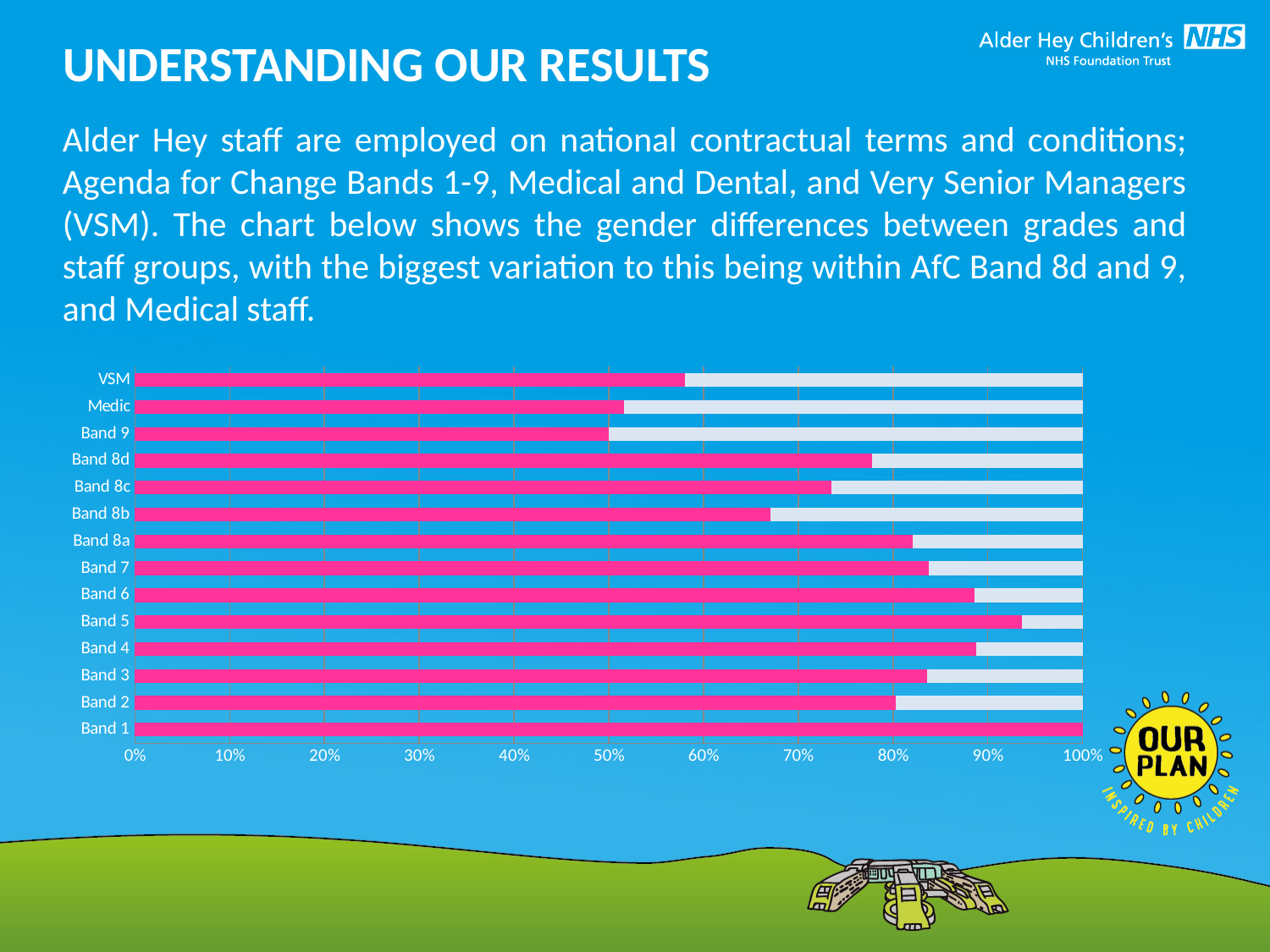
How many categories (staff groups/bands) are listed on the vertical axis of the chart? 14 Is the pink bar for Band 8b greater or less than 70%? less Is the pink bar for Band 5 greater or less than 90%? greater Which category has the longest pink bar in the chart? Band 1 Is the pink bar for VSM greater or less than 50%? greater Which has the larger pink share, Band 8d or Band 8b? Band 8d Which has the larger pink share, Band 5 or Band 2? Band 5 What kind of chart is shown on the slide? Stacked bar chart What is the highest value shown on the horizontal axis of the chart? 100% What percentage does the pink bar for Band 1 reach? 100%